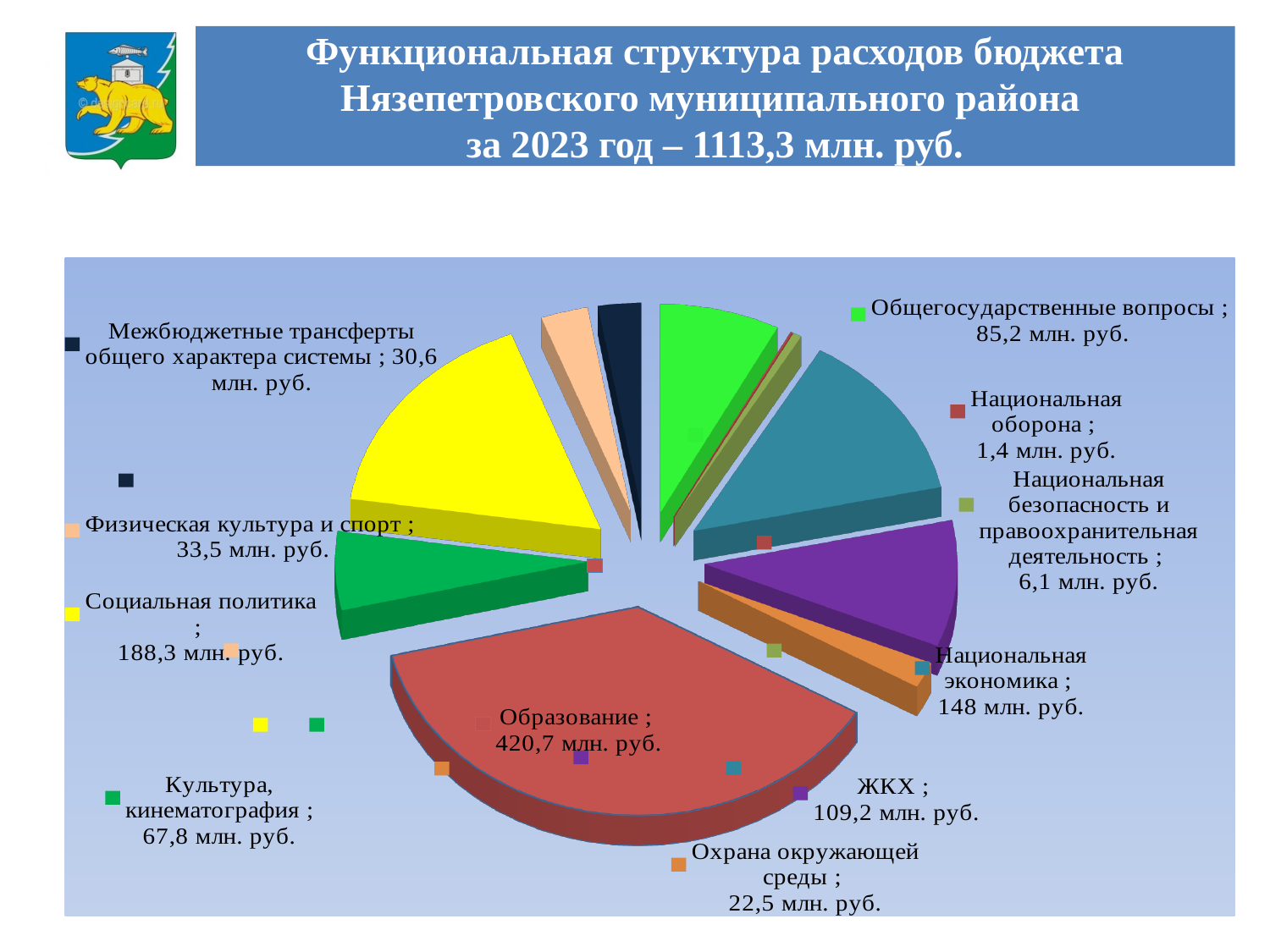
How many categories does the pie chart show? 11 What is the value for Национальная экономика? 148 млн. руб. What total amount of expenditure for 2023 is stated in the slide title? 1113,3 млн. руб. Which category has the smallest value? Национальная оборона What colour is the Образование slice? red What type of chart is shown on the slide? pie chart Which is larger, ЖКХ or Культура, кинематография? ЖКХ What is the difference between Социальная политика and Национальная экономика? 40,3 млн. руб. Which category has the largest value? Образование What is the value for Физическая культура и спорт? 33,5 млн. руб. What is the value for Образование? 420,7 млн. руб. What is the value for Охрана окружающей среды? 22,5 млн. руб.